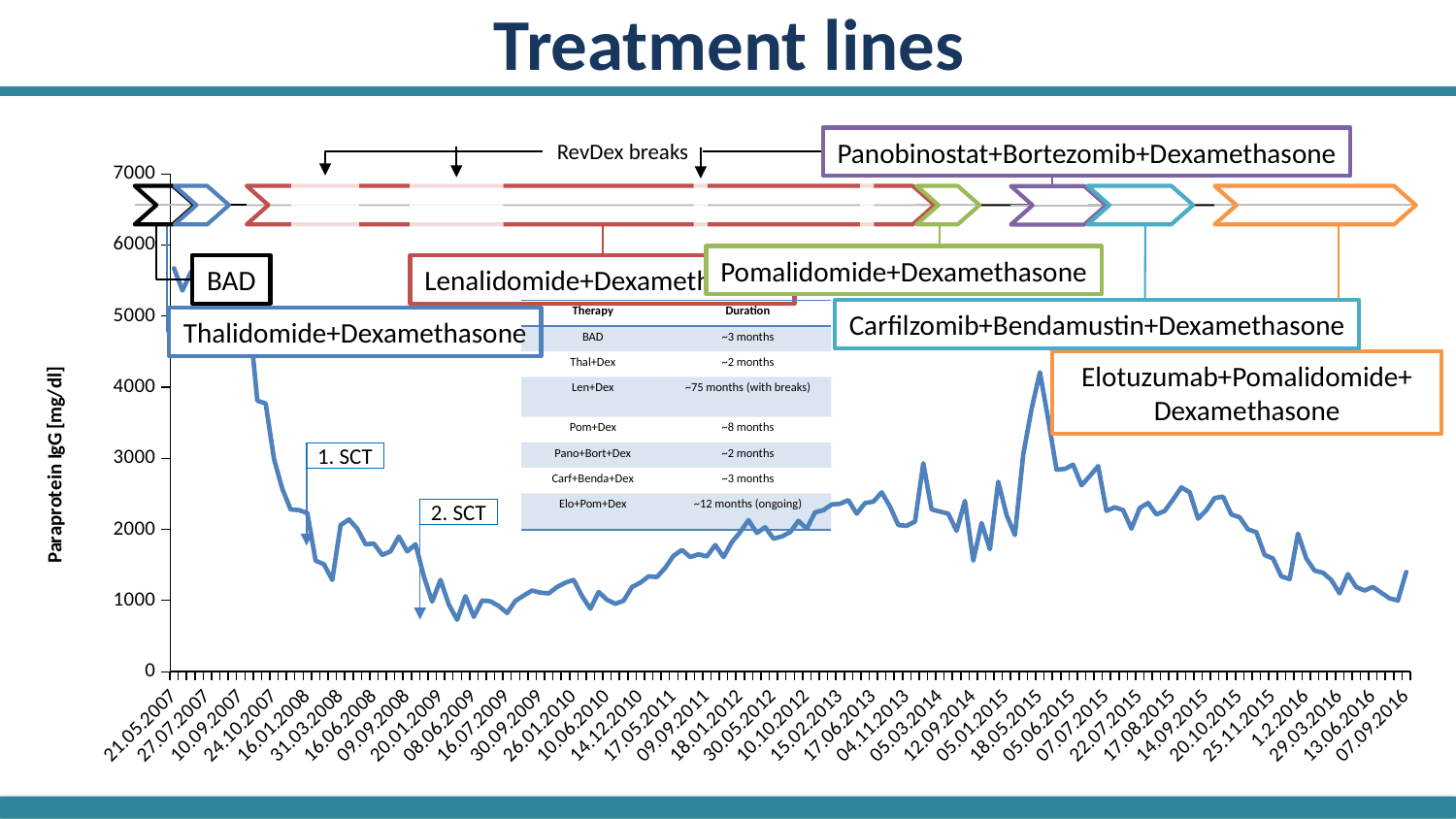
Which is larger, the paraprotein value at 18.05.2015 or at 07.09.2016? 18.05.2015 Is the paraprotein value at 17.06.2013 greater or less than 2000? greater How many lines are plotted on the chart? 1 Does the paraprotein value rise or fall between 24.10.2007 and 20.01.2009? fall What kind of chart is shown on the slide? line chart Is the peak paraprotein value around 18.05.2015 greater or less than 3000? greater What is the highest tick value shown on the y axis? 7000 Does the paraprotein value rise or fall between 08.06.2009 and 15.02.2013? rise Is the paraprotein value at 10.06.2010 greater or less than 2000? less What is the label of the y axis of the chart? Paraprotein IgG [mg/dl]